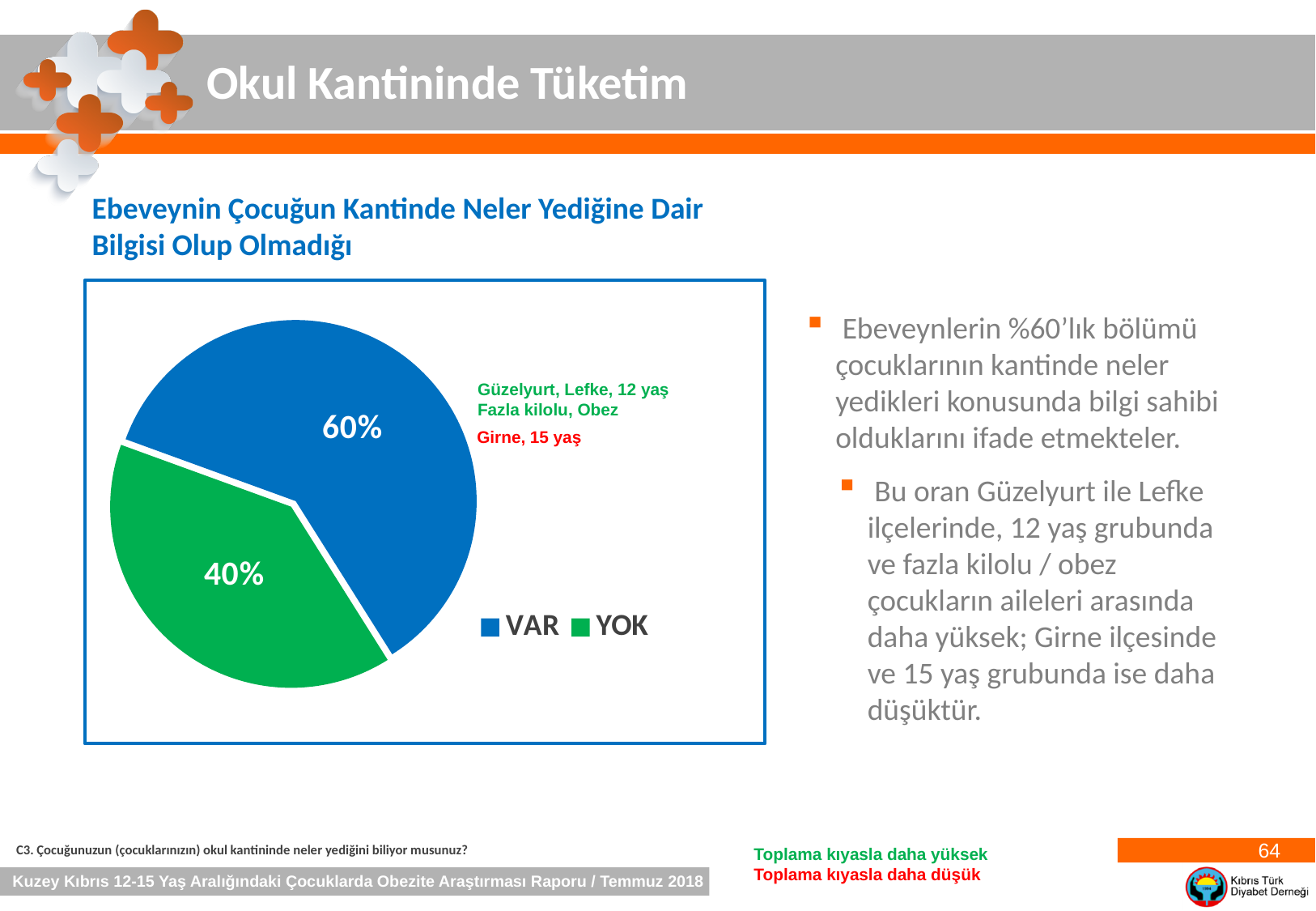
What colour is the VAR slice in the pie chart? blue What colour is the YOK slice in the pie chart? green What is the difference between the VAR and YOK shares? 20% Which category has the largest share of the pie? VAR What is the value for YOK in the pie chart? 40% What is the value for VAR in the pie chart? 60% What share of the pie does the YOK slice represent? 40% How many entries does the legend list? 2 How many slices does the pie chart have? 2 What kind of chart is shown on the slide? pie chart Which is larger, the share for VAR or the share for YOK? VAR Which category has the smallest share of the pie? YOK